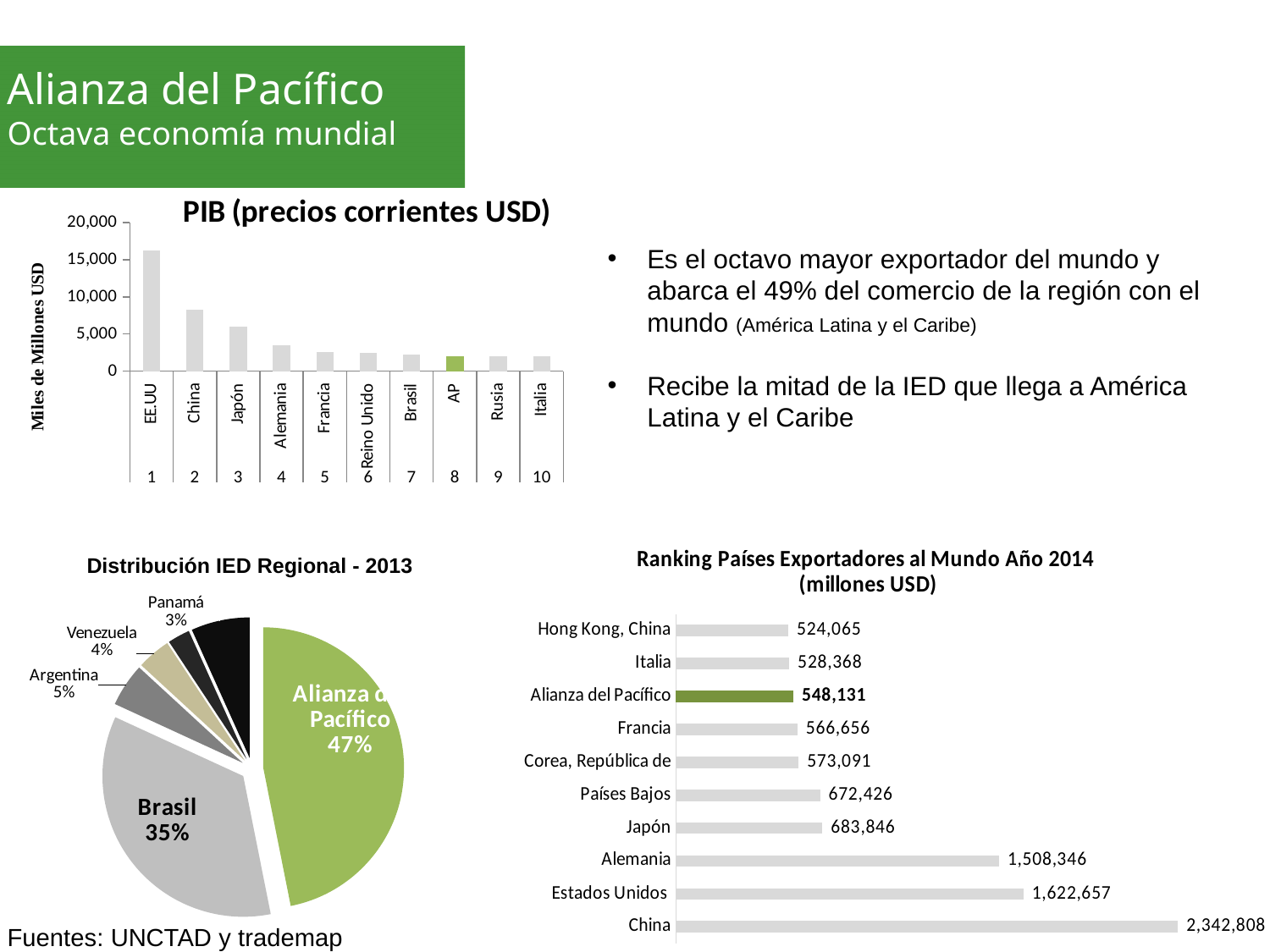
In the 'Ranking Países Exportadores al Mundo Año 2014' chart, which category has the lowest value? Hong Kong, China In the 'Distribución IED Regional - 2013' pie chart, which is larger, Argentina or Venezuela? Argentina In the 'PIB (precios corrientes USD)' chart, which country has the highest value? EE.UU How many countries are listed in the 'Ranking Países Exportadores al Mundo Año 2014' chart? 10 In the 'PIB (precios corrientes USD)' chart, is the value for EE.UU greater or less than 15,000? greater In the 'Ranking Países Exportadores al Mundo Año 2014' chart, what is the value for Alianza del Pacífico? 548,131 In the 'Distribución IED Regional - 2013' pie chart, what is the difference in percentage points between Alianza del Pacífico and Brasil? 12 In the 'Ranking Países Exportadores al Mundo Año 2014' chart, which is larger, Japón or Países Bajos? Japón In the 'Ranking Países Exportadores al Mundo Año 2014' chart, which country has the highest value? China In the 'Ranking Países Exportadores al Mundo Año 2014' chart, what is the difference between Estados Unidos and Alemania? 114,311 What kind of chart is the 'PIB (precios corrientes USD)' chart? Bar chart In the 'Distribución IED Regional - 2013' pie chart, what share does Brasil have? 35%